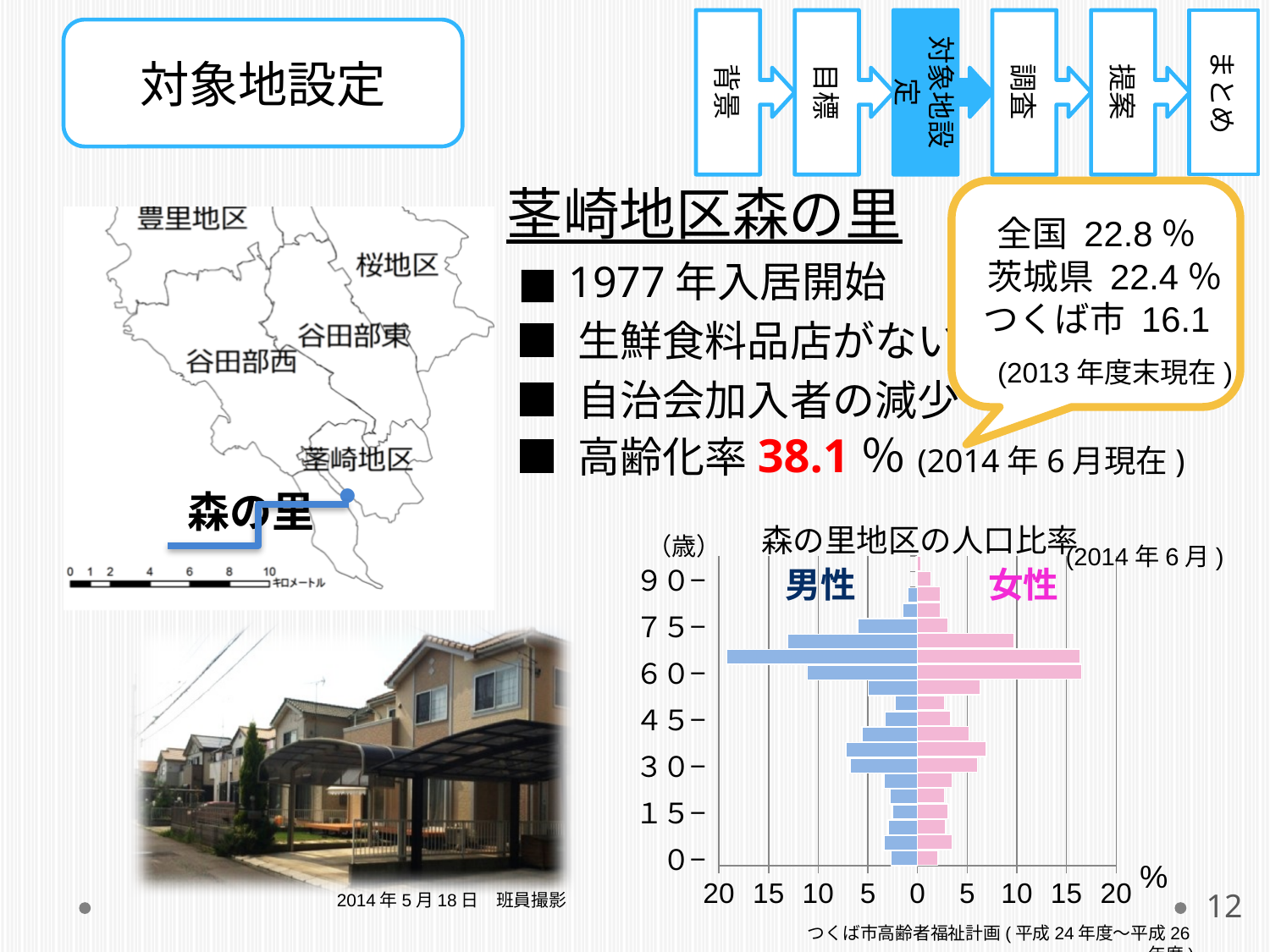
Is the male (男性) value for the 0- age group greater or less than 5%? less Is the longest male (男性) bar greater or less than 15%? greater Is the female (女性) value for the 0- age group greater or less than 5%? less How many age labels are printed on the vertical axis of the chart? 7 Are the bars for the age groups between 0- and 15- shorter or longer than the bars around the 60- age group? shorter In which age range do the longest bars for both 男性 and 女性 fall: between 0- and 30-, or between 60- and 75-? between 60- and 75- Which side of the pyramid has the single longest bar, 男性 or 女性? 男性 How many series does the chart distinguish, and what are they? 2: 男性 and 女性 What is the title of the chart at the bottom right of the slide? 森の里地区の人口比率 What kind of chart is shown at the bottom right of the slide? bar chart (population pyramid) What unit is shown at the end of the horizontal axis of the chart? %